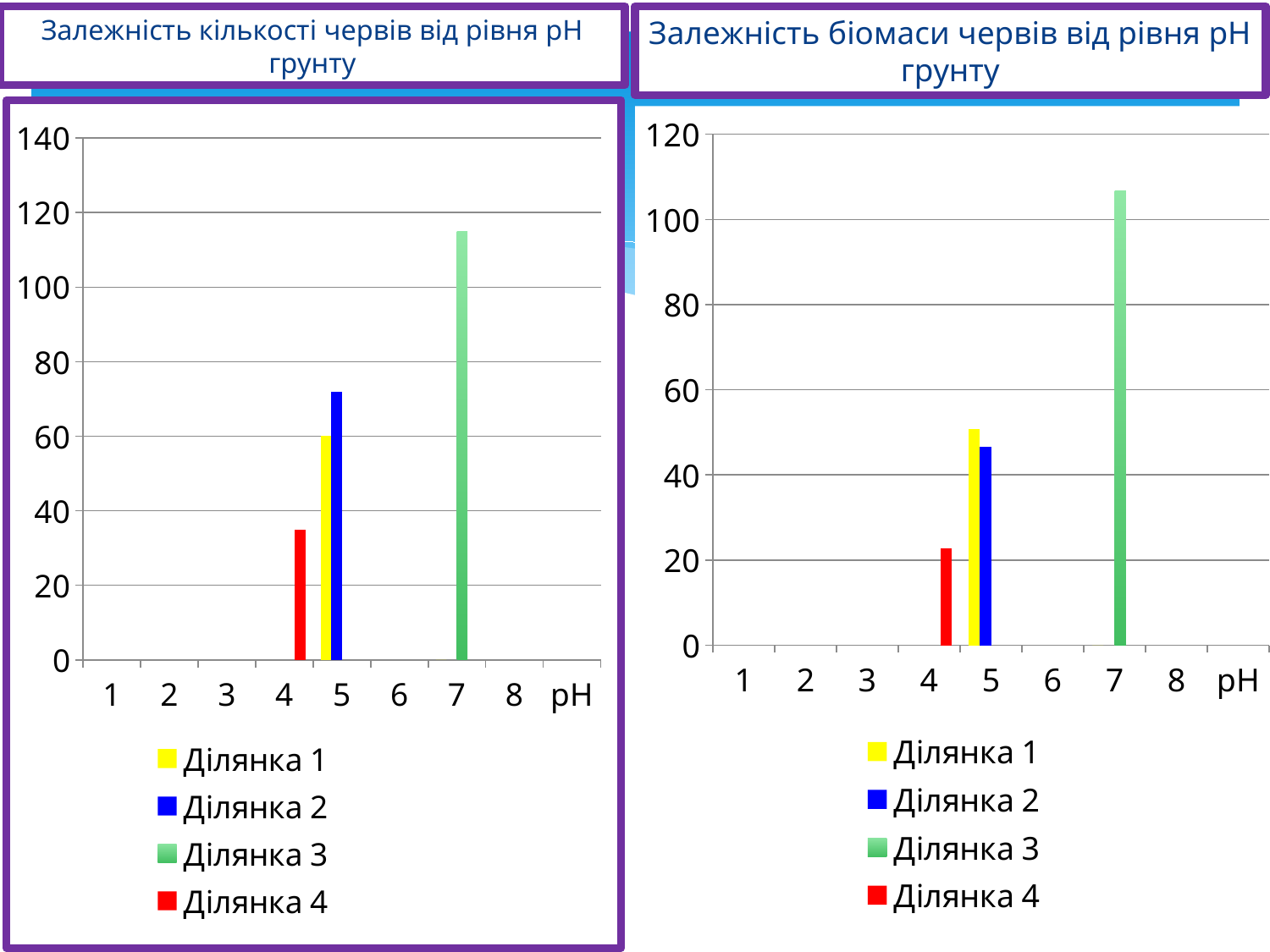
In the left chart (Залежність кількості червів від рівня pH ґрунту), which series has the highest bar? Ділянка 3 In the left chart (Залежність кількості червів від рівня pH ґрунту), how many series does the legend list? 4 In the right chart (Залежність біомаси червів від рівня pH ґрунту), what colour represents Ділянка 3 in the legend? green In the left chart (Залежність кількості червів від рівня pH ґрунту), which series has the lowest bar? Ділянка 4 In the right chart (Залежність біомаси червів від рівня pH ґрунту), which series has the highest bar? Ділянка 3 In the right chart (Залежність біомаси червів від рівня pH ґрунту), is the value for Ділянка 3 greater or less than 100? greater In the left chart (Залежність кількості червів від рівня pH ґрунту), what kind of chart is shown? bar chart In the left chart (Залежність кількості червів від рівня pH ґрунту), is the value for Ділянка 3 greater or less than 100? greater In the right chart (Залежність біомаси червів від рівня pH ґрунту), is the value for Ділянка 4 greater or less than 40? less In the right chart (Залежність біомаси червів від рівня pH ґрунту), which series has the lowest bar? Ділянка 4 In the left chart (Залежність кількості червів від рівня pH ґрунту), which is larger, the bar for Ділянка 1 or the bar for Ділянка 2? Ділянка 2